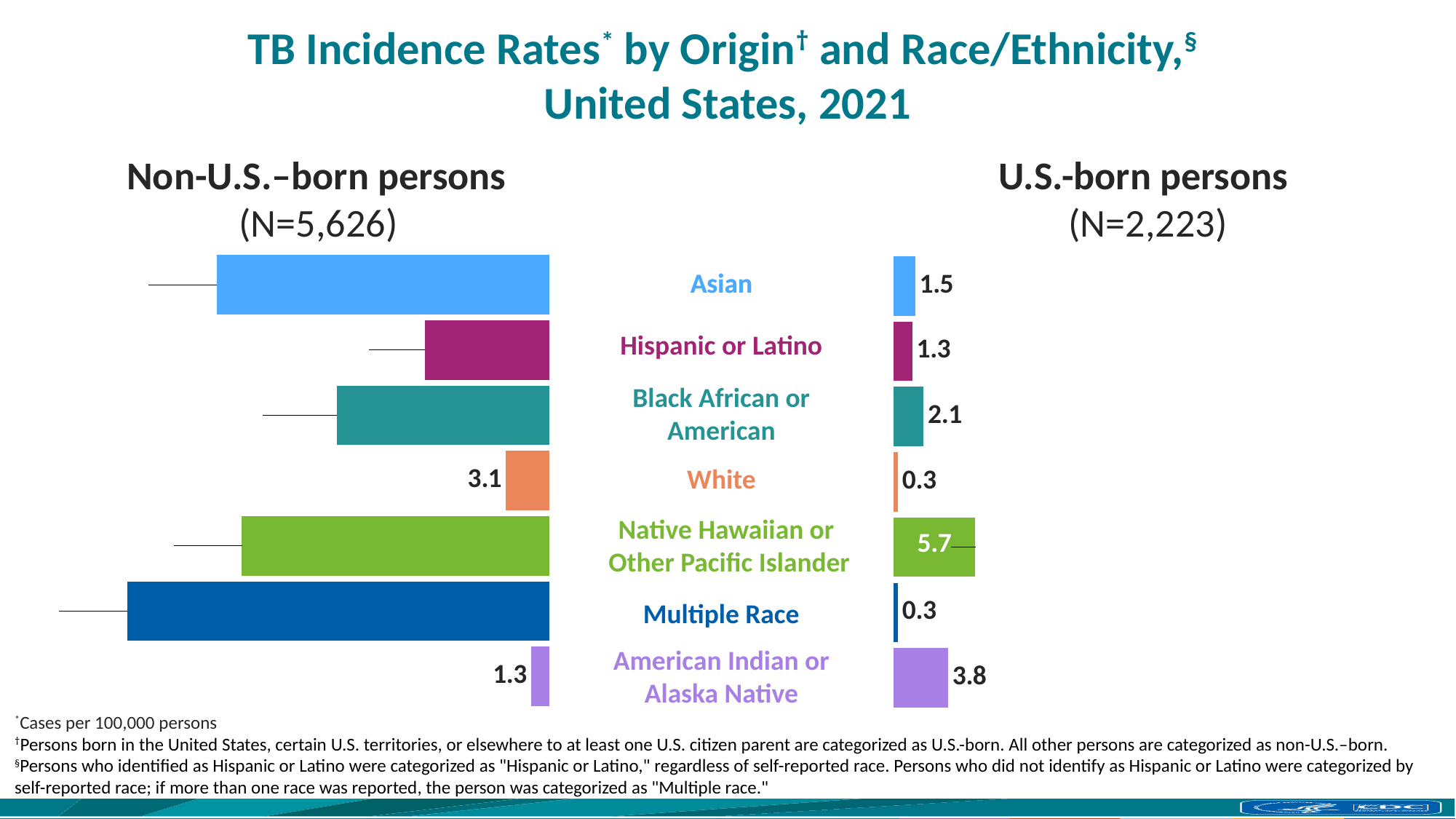
In the U.S.-born persons chart, what is the difference between the rates for Native Hawaiian or Other Pacific Islander and American Indian or Alaska Native persons? 1.9 What kind of chart is shown on the slide? Bar chart In the U.S.-born persons chart, which race/ethnicity has the highest TB incidence rate? Native Hawaiian or Other Pacific Islander In the Non-U.S.-born persons chart, which race/ethnicity has the lowest TB incidence rate? American Indian or Alaska Native In the U.S.-born persons chart, what is the TB incidence rate for Black African or American persons? 2.1 In the U.S.-born persons chart, what is the TB incidence rate for Native Hawaiian or Other Pacific Islander persons? 5.7 In the Non-U.S.-born persons chart, what is the TB incidence rate for White persons? 3.1 In the Non-U.S.-born persons chart, what is the TB incidence rate for American Indian or Alaska Native persons? 1.3 In the Non-U.S.-born persons chart, which race/ethnicity has the longest bar? Multiple Race How many race/ethnicity categories are plotted in the chart? 7 In the U.S.-born persons chart, what is the TB incidence rate for American Indian or Alaska Native persons? 3.8 In the U.S.-born persons chart, which is larger: the rate for Asian persons or for Hispanic or Latino persons? Asian